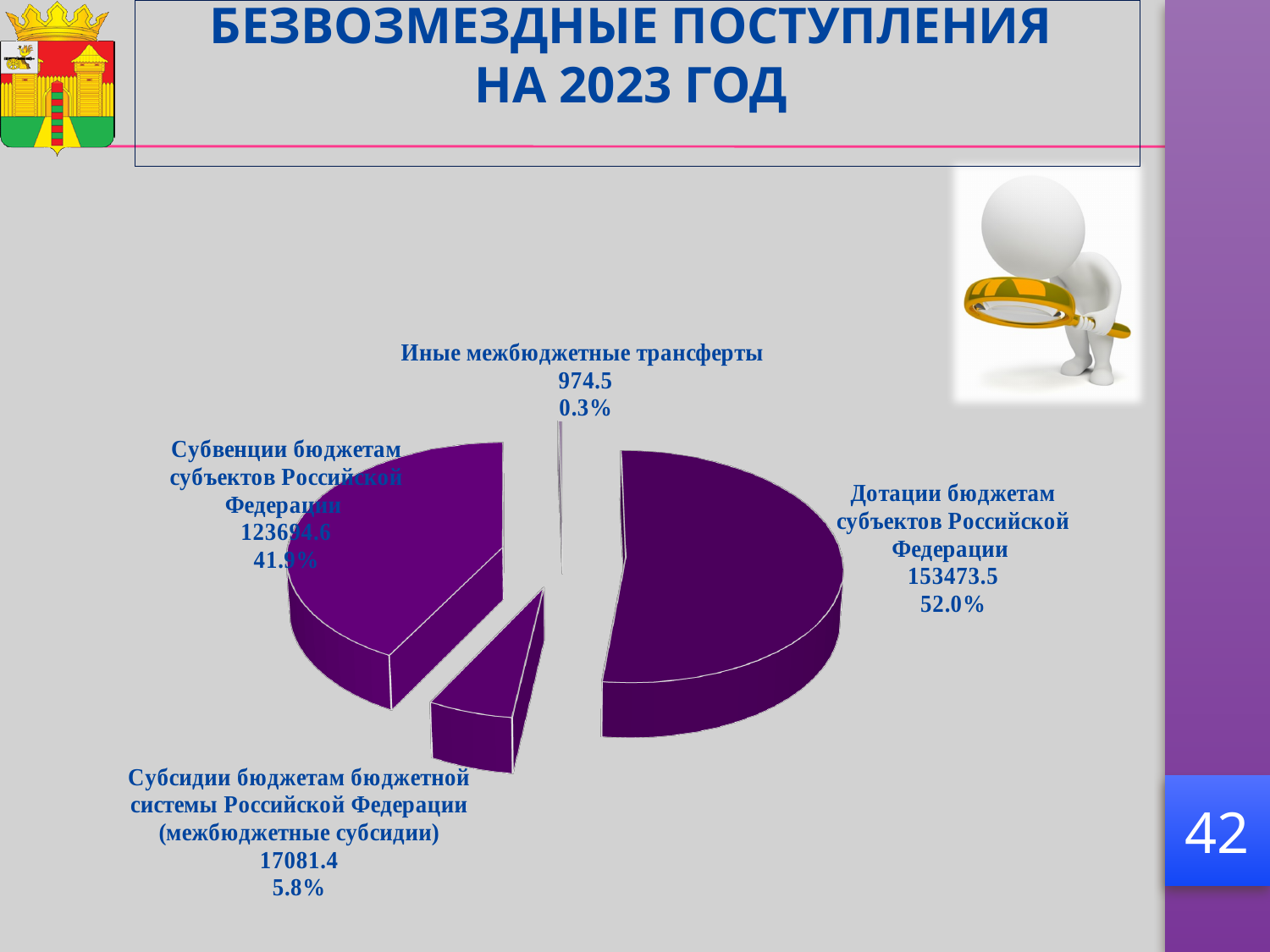
Which is larger: the value for Субсидии бюджетам бюджетной системы Российской Федерации (межбюджетные субсидии) or the value for Иные межбюджетные трансферты? Субсидии бюджетам бюджетной системы Российской Федерации (межбюджетные субсидии) Which category has the smallest slice of the pie? Иные межбюджетные трансферты How many slices does the pie chart have? 4 What is the value for Дотации бюджетам субъектов Российской Федерации? 153473.5 What is the value for Субсидии бюджетам бюджетной системы Российской Федерации (межбюджетные субсидии)? 17081.4 What share of the pie does Субсидии бюджетам бюджетной системы Российской Федерации (межбюджетные субсидии) represent? 5.8% What share of the pie does Иные межбюджетные трансферты represent? 0.3% Which category has the largest slice of the pie? Дотации бюджетам субъектов Российской Федерации What kind of chart is shown on the slide? pie chart What is the difference between the value for Дотации бюджетам субъектов Российской Федерации and the value for Субсидии бюджетам бюджетной системы Российской Федерации (межбюджетные субсидии)? 136392.1 What share of the pie does Дотации бюджетам субъектов Российской Федерации represent? 52.0% What is the value for Иные межбюджетные трансферты? 974.5